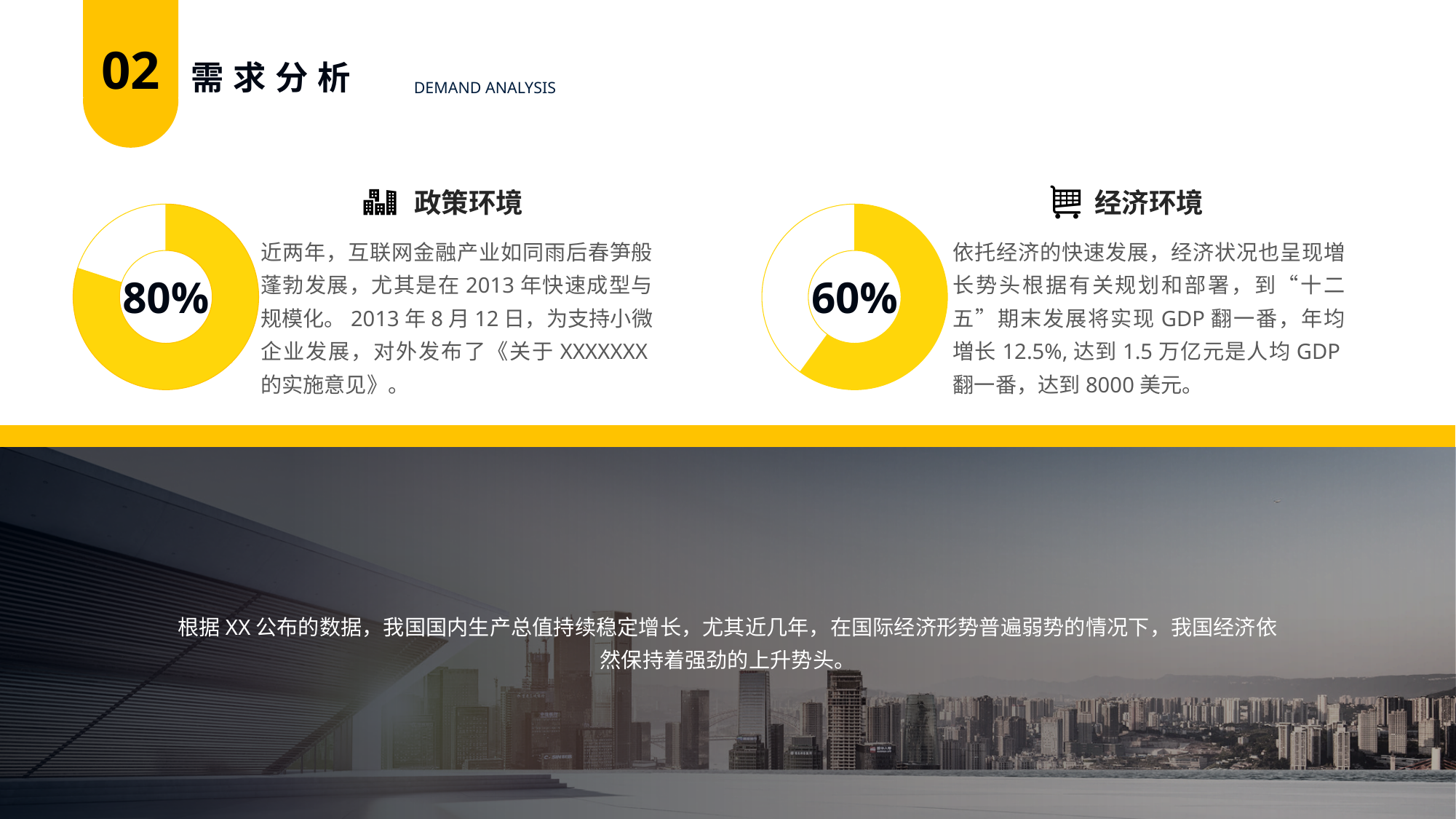
What colour is the filled portion of the doughnut charts on the slide? yellow How many doughnut charts are on the slide? 2 Which of the two doughnut charts shows the lowest value? the right 经济环境 chart What heading appears next to the doughnut chart on the right? 经济环境 On the left 政策环境 doughnut chart, what share of the ring is filled in yellow? 80% On the right 经济环境 doughnut chart, what share of the ring is filled in yellow? 60% What kind of chart is used for the 政策环境 figure on the left? doughnut chart Which chart shows the larger value, the left 政策环境 chart or the right 经济环境 chart? the left 政策环境 chart What percentage is shown in the centre of the doughnut chart on the left, next to 政策环境? 80% What kind of chart is used for the 经济环境 figure on the right? doughnut chart What is the difference between the value on the left 政策环境 chart and the value on the right 经济环境 chart? 20% What percentage is shown in the centre of the doughnut chart on the right, next to 经济环境? 60%